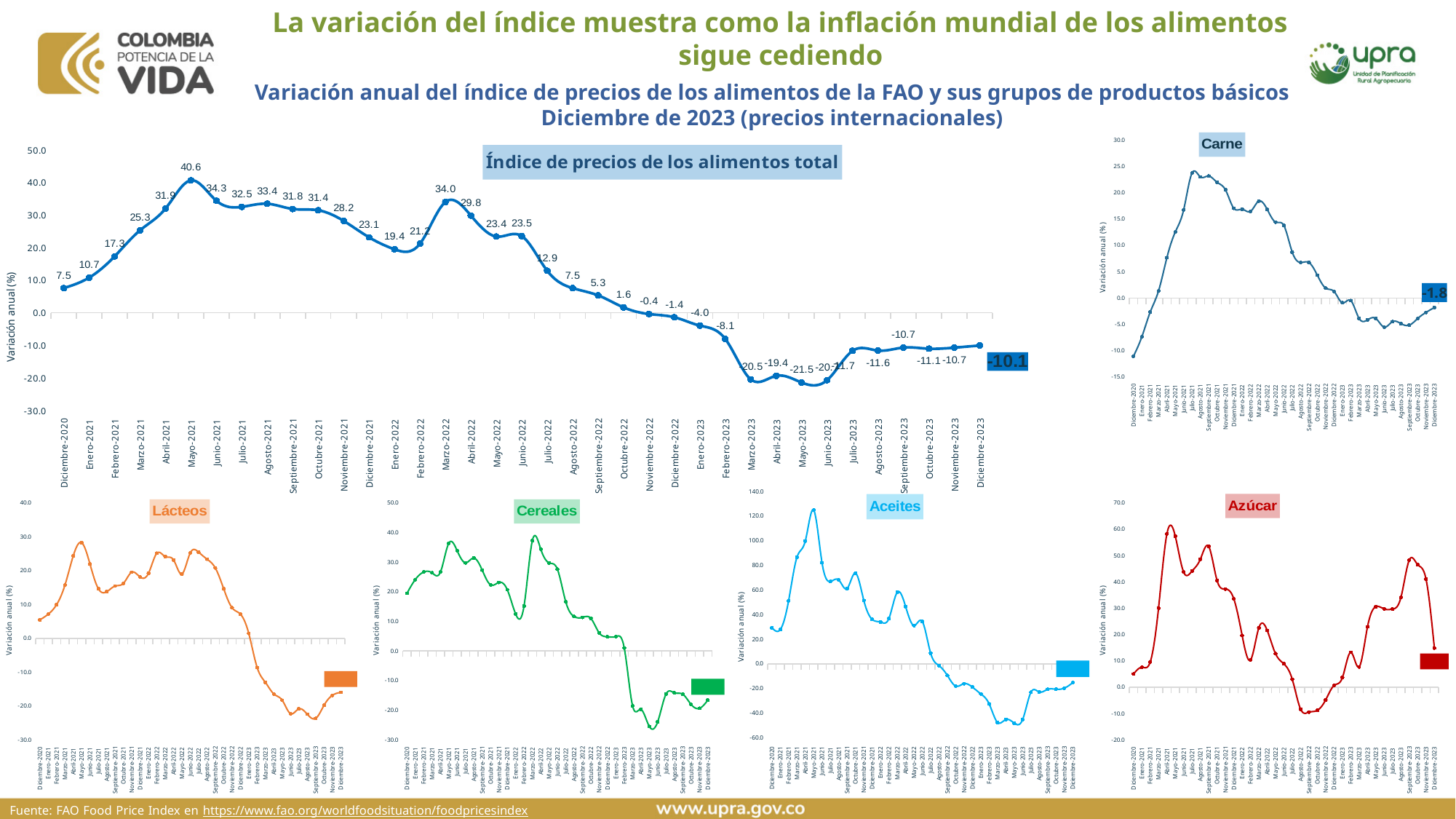
On the 'Índice de precios de los alimentos total' chart, what is the value for Mayo-2021? 40.6 On the 'Carne' chart, what is the value for Diciembre-2023? -1.8 How many charts are shown on the slide? 6 On the 'Índice de precios de los alimentos total' chart, which month has the highest value? Mayo-2021 On the 'Índice de precios de los alimentos total' chart, what is the value for Diciembre-2023? -10.1 On the 'Aceites' chart, is the peak value in 2021 greater or less than 100.0? greater On the 'Lácteos' chart, is the value for Diciembre-2023 greater or less than 0.0? less On the 'Índice de precios de los alimentos total' chart, which is larger, the value for Marzo-2022 or the value for Junio-2021? Junio-2021 On the 'Índice de precios de los alimentos total' chart, which month has the lowest value? Mayo-2023 On the 'Índice de precios de los alimentos total' chart, what is the difference between the values for Mayo-2021 and Diciembre-2023? 50.7 What kind of chart is the 'Cereales' chart? Line chart On the 'Azúcar' chart, is the peak value in 2021 greater or less than 50.0? greater